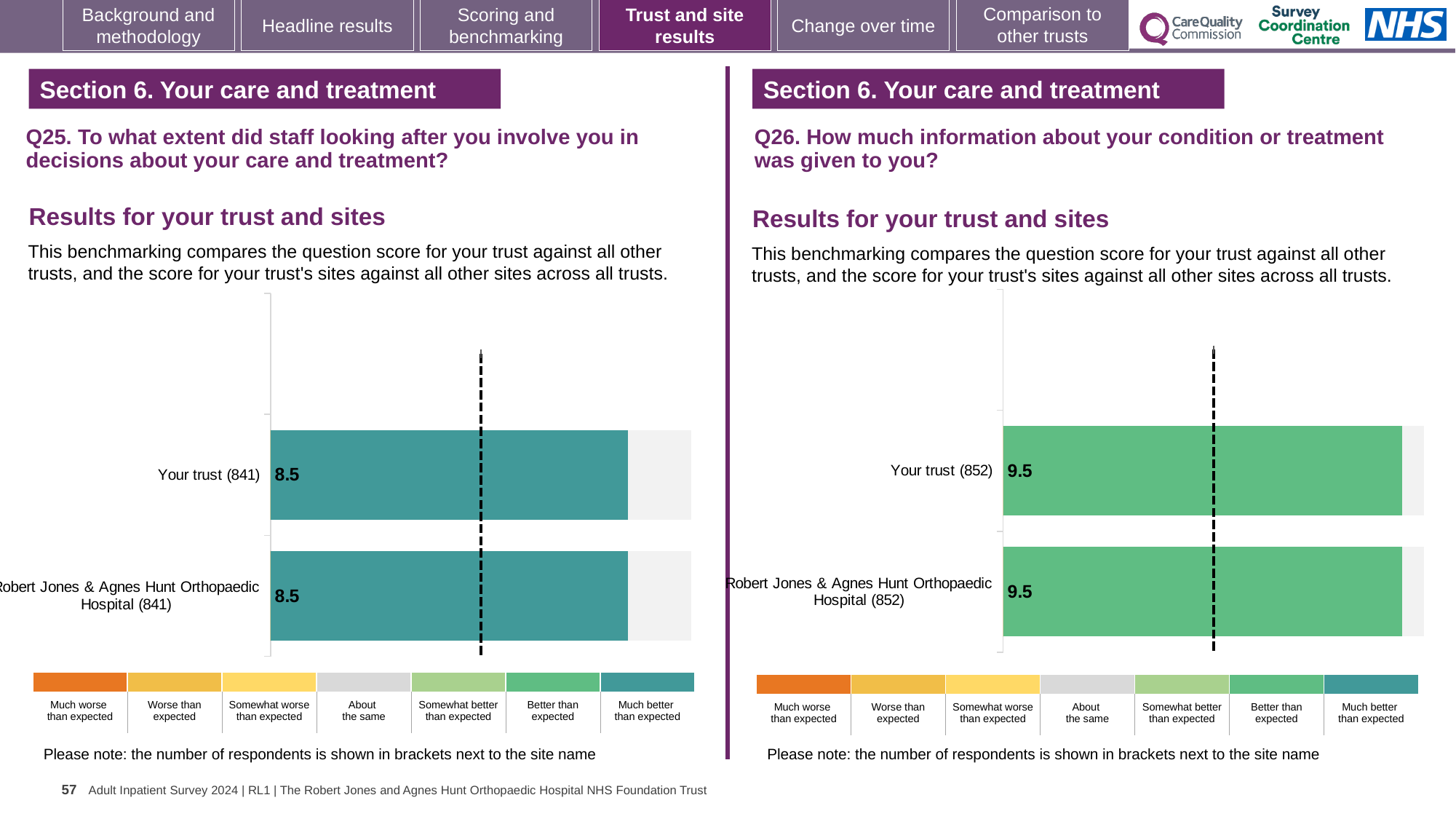
On the Q26 chart (right), what is the score for Robert Jones & Agnes Hunt Orthopaedic Hospital? 9.5 On the Q26 chart (right), what is the score for Your trust? 9.5 On the Q26 chart (right), what is the difference between the score for Your trust and the score for Robert Jones & Agnes Hunt Orthopaedic Hospital? 0 On the Q25 chart (left), what is the difference between the score for Your trust and the score for Robert Jones & Agnes Hunt Orthopaedic Hospital? 0 How many bars are plotted on the Q25 chart (left)? 2 How many bars are plotted on the Q26 chart (right)? 2 How many respondents are shown in brackets for Your trust on the Q26 chart (right)? 852 On the Q25 chart (left), what is the score for Your trust? 8.5 On the Q25 chart (left), what is the score for Robert Jones & Agnes Hunt Orthopaedic Hospital? 8.5 What kind of chart is the Q26 chart (right)? Bar chart How many categories does the colour key below the Q25 chart (left) list? 7